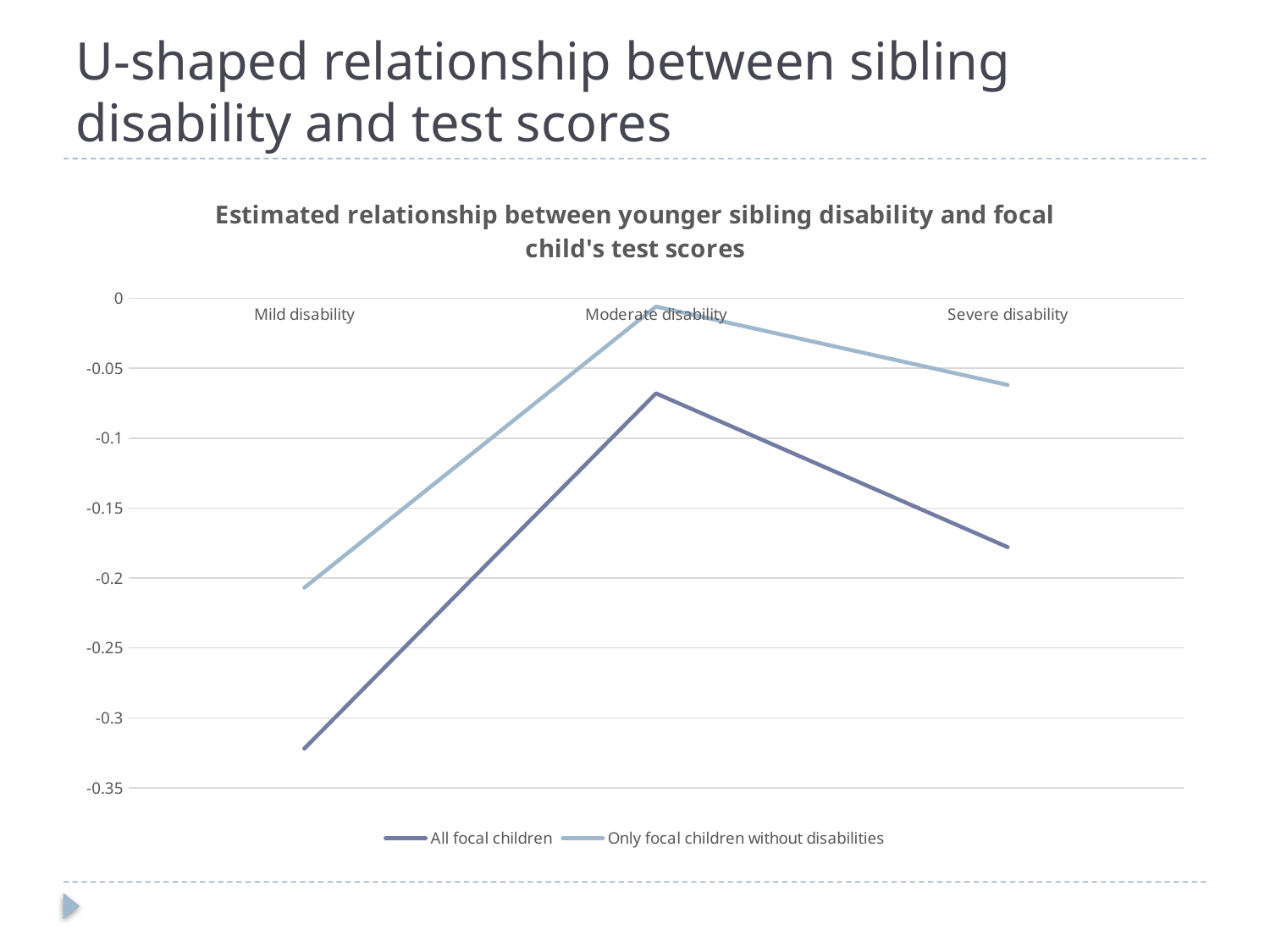
For the All focal children series, do the values rise or fall from Moderate disability to Severe disability? fall For the All focal children series, which category has the highest value? Moderate disability What kind of chart is shown on the slide? line chart How many categories are shown on the x axis? 3 For the All focal children series, which category has the lowest value? Mild disability At Severe disability, which series has the larger value: All focal children or Only focal children without disabilities? Only focal children without disabilities Which series is drawn in the lighter blue line? Only focal children without disabilities What is the title of the chart? Estimated relationship between younger sibling disability and focal child's test scores Is the value for Mild disability in the All focal children series greater or less than -0.3? less How many series does the legend list? 2 Is the value for Severe disability in the Only focal children without disabilities series greater or less than -0.1? greater For the Only focal children without disabilities series, which category has the lowest value? Mild disability